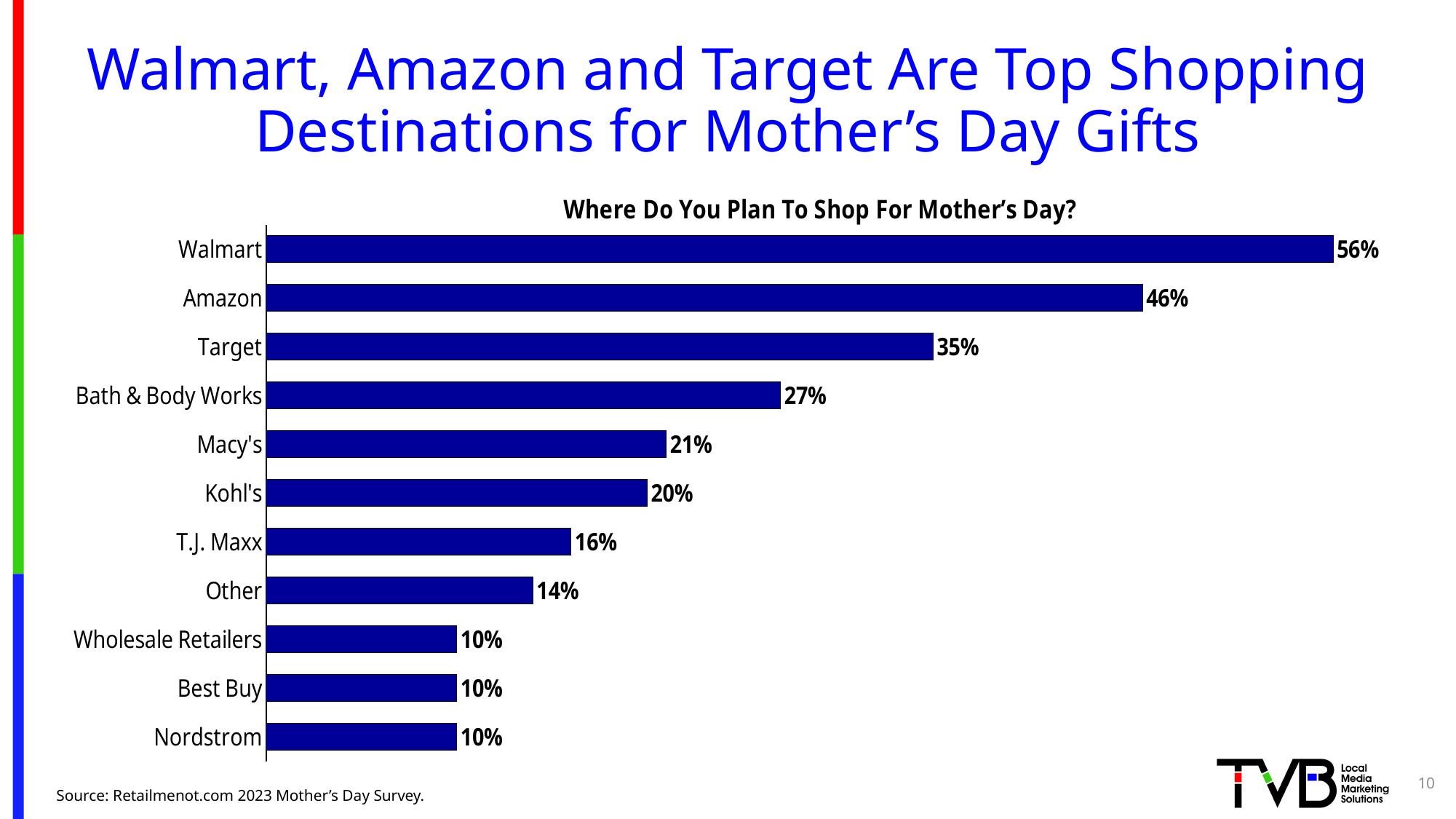
How many destinations share the lowest value of 10%? 3 What percentage of respondents plan to shop at Walmart for Mother's Day? 56% Which has a larger value, Kohl's or Other? Kohl's What is the difference between the values for Walmart and Amazon? 10% What kind of chart is shown on the slide? Bar chart What is the value shown for Bath & Body Works? 27% What is the difference between the values for Target and Macy's? 14% Which has a larger value, Amazon or Target? Amazon What is the title of the chart? Where Do You Plan To Shop For Mother's Day? Which shopping destination has the highest percentage? Walmart How many shopping destinations are listed in the chart? 11 What percentage is shown for T.J. Maxx? 16%